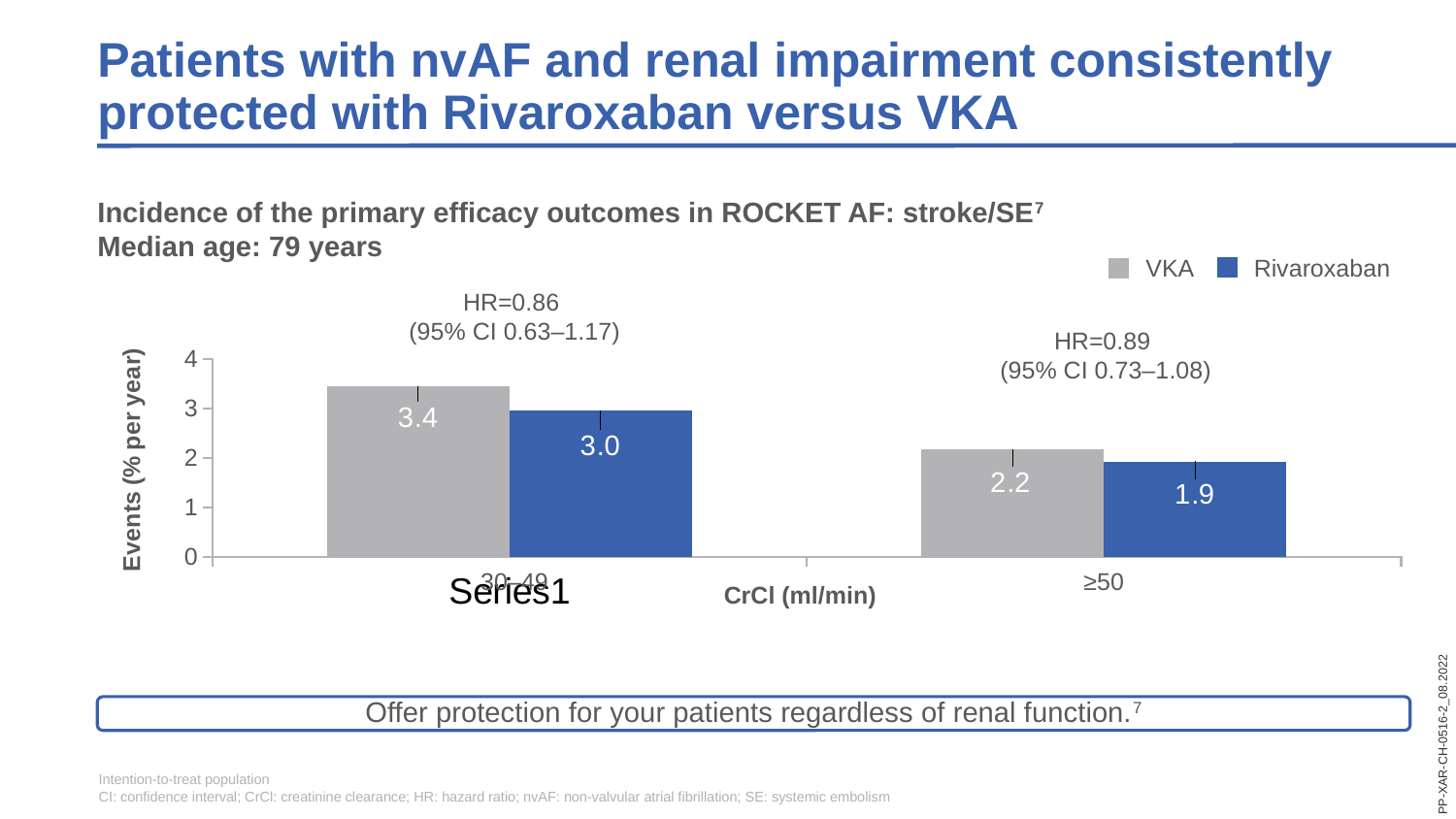
In the left group (CrCl 30–49 ml/min), how much higher is the VKA event rate than the Rivaroxaban event rate? 0.4 What is the label of the vertical axis? Events (% per year) How many series does the legend list? 2 Which bar shows the lowest event rate on the chart? Rivaroxaban in the CrCl ≥50 group (1.9) What is the Rivaroxaban event rate for the CrCl ≥50 ml/min group? 1.9 What kind of chart is shown on the slide? Bar chart In the CrCl ≥50 ml/min group, what is the difference between the VKA and Rivaroxaban event rates? 0.3 What is the VKA event rate in the left group (CrCl 30–49 ml/min)? 3.4 What is the Rivaroxaban event rate in the left group (CrCl 30–49 ml/min)? 3.0 Which bar shows the highest event rate on the chart? VKA in the CrCl 30–49 group (3.4) What is the VKA event rate for the CrCl ≥50 ml/min group? 2.2 In the CrCl ≥50 ml/min group, which treatment has the higher event rate, VKA or Rivaroxaban? VKA